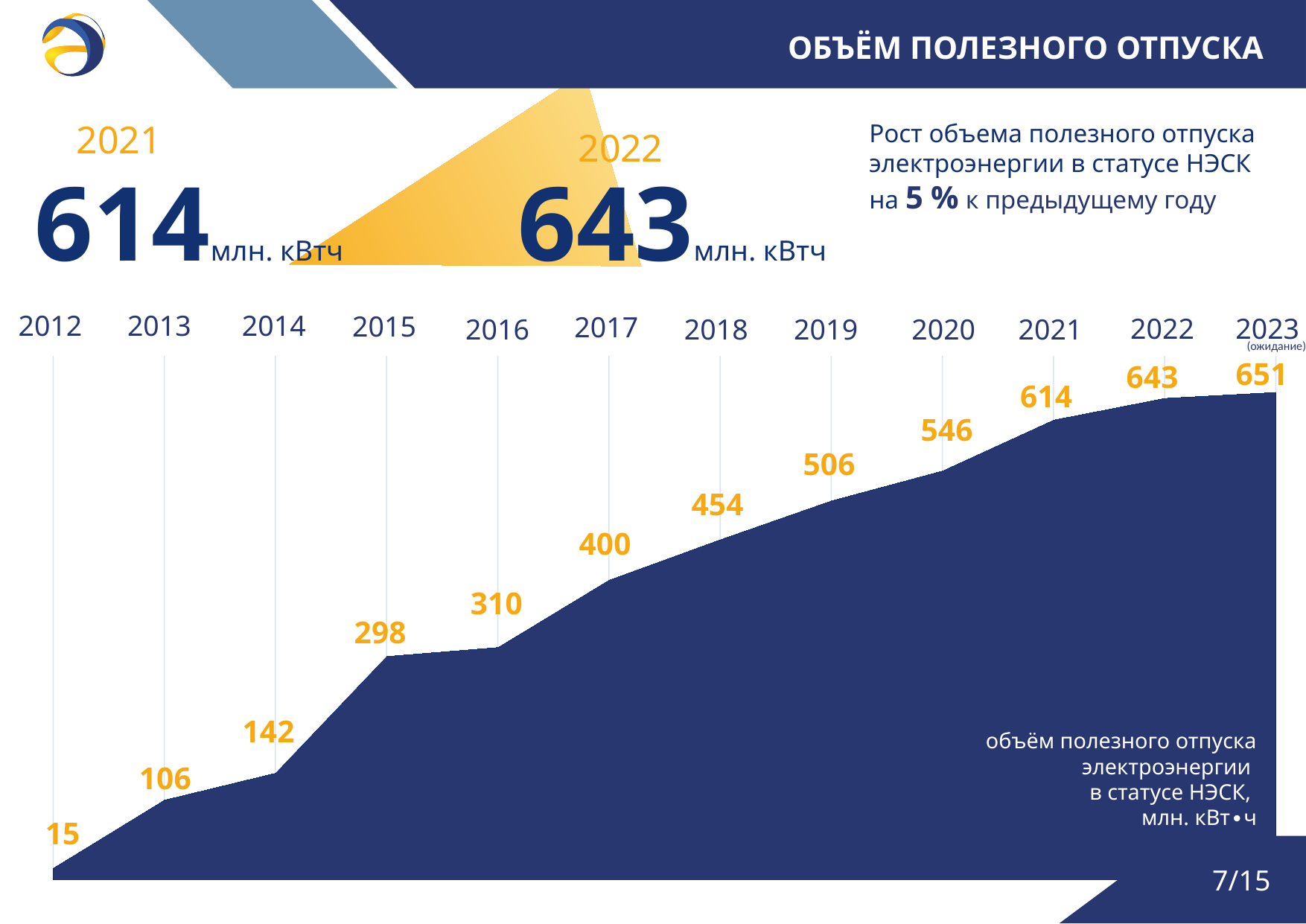
What is the difference between the values for 2022 and 2021? 29 Which year has the lowest value in the chart? 2012 What is the value for 2015 in the chart? 298 Which year has the highest value in the chart? 2023 What is the difference between the values for 2014 and 2013? 36 Which is larger, the value for 2016 or the value for 2017? 2017 What is the value for 2018 in the chart? 454 What is the expected value for 2023 in the chart? 651 How many years are shown on the x axis of the chart? 12 Do the values rise or fall from 2012 to 2023? rise What unit is given for the values in the chart? млн. кВт•ч What kind of chart is shown on the slide? area chart